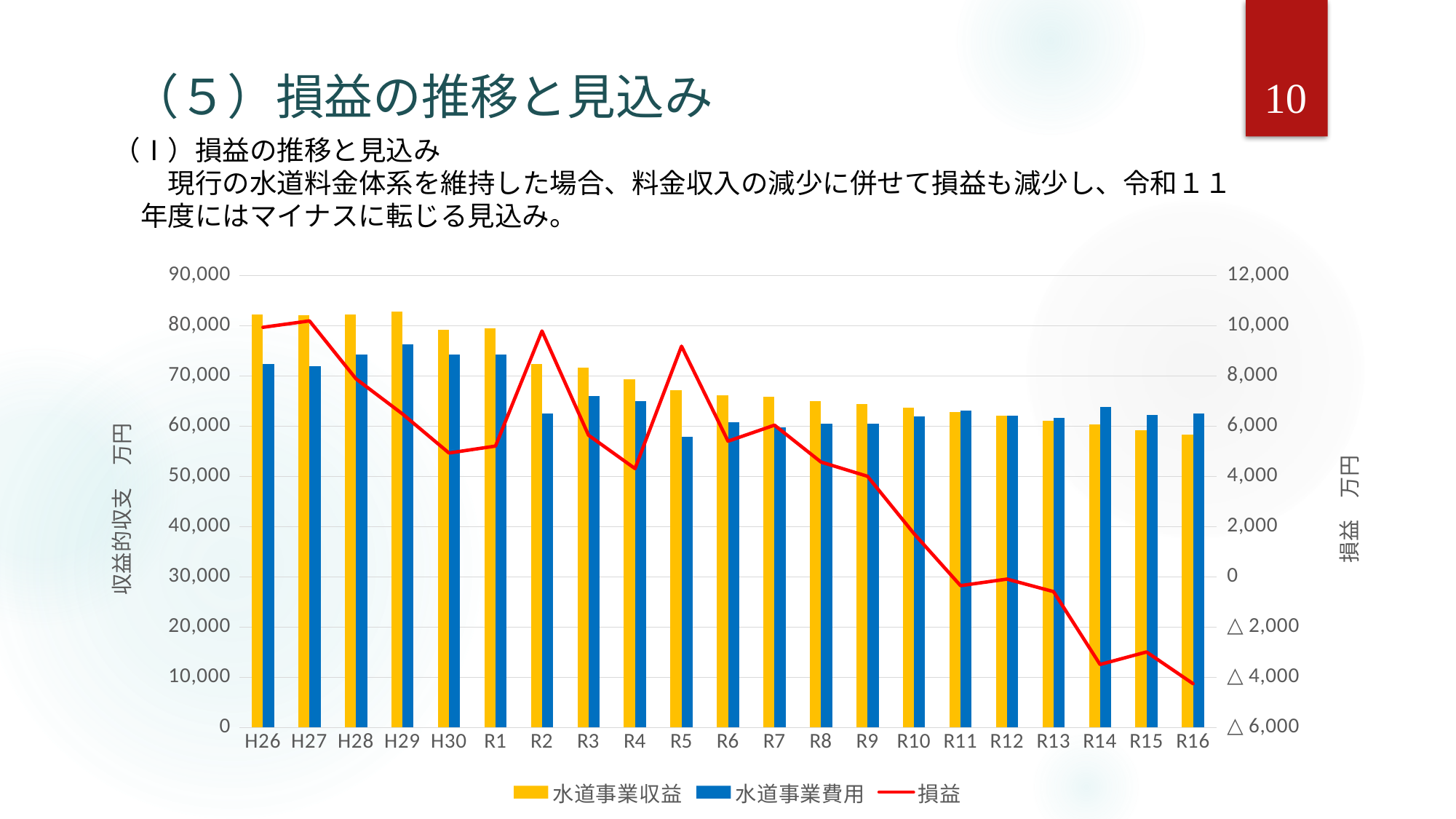
Is the value of 損益 for R2 greater or less than 8,000 on the right axis? greater For H26, which is larger: 水道事業収益 or 水道事業費用? 水道事業収益 Which year has the lowest value of 損益? R16 For R14, which is larger: 水道事業収益 or 水道事業費用? 水道事業費用 How many categories (years) are shown on the x axis? 21 How many series does the legend list? 3 Is the value of 水道事業収益 for H26 greater or less than 80,000? greater Is the value of 損益 for R16 greater or less than 0 on the right axis? less Does 水道事業収益 generally rise or fall from H26 to R16? fall What kind of chart is shown on the slide? A combined bar and line chart